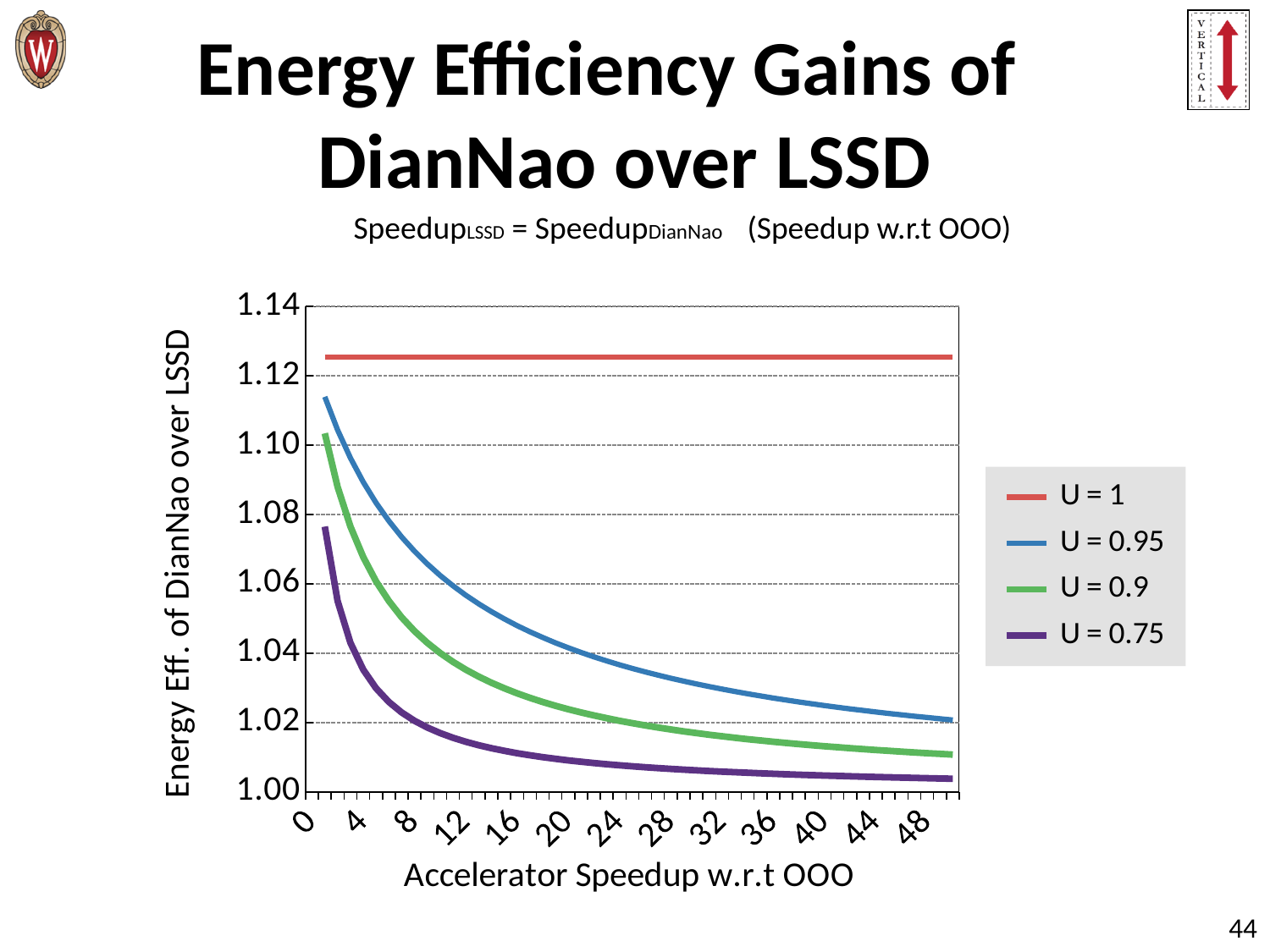
Which series has the highest energy efficiency gain across the whole x-axis range? U = 1 What colour is the U = 0.9 line in the legend? green At a speedup of 20, which series has the larger value: U = 0.95 or U = 0.75? U = 0.95 What is the label of the x-axis? Accelerator Speedup w.r.t OOO Is the value of the U = 1 line greater or less than 1.12? greater Is the value of the U = 0.95 line at a speedup of 48 greater or less than 1.04? less What kind of chart is shown on the slide? line chart How many series does the legend list? 4 Does the U = 0.95 line rise or fall as accelerator speedup increases? fall Is the value of the U = 0.75 line at a speedup of 48 greater or less than 1.02? less Does the U = 1 line rise, fall, or stay flat as accelerator speedup increases? stay flat Which series has the lowest energy efficiency gain across the whole x-axis range? U = 0.75